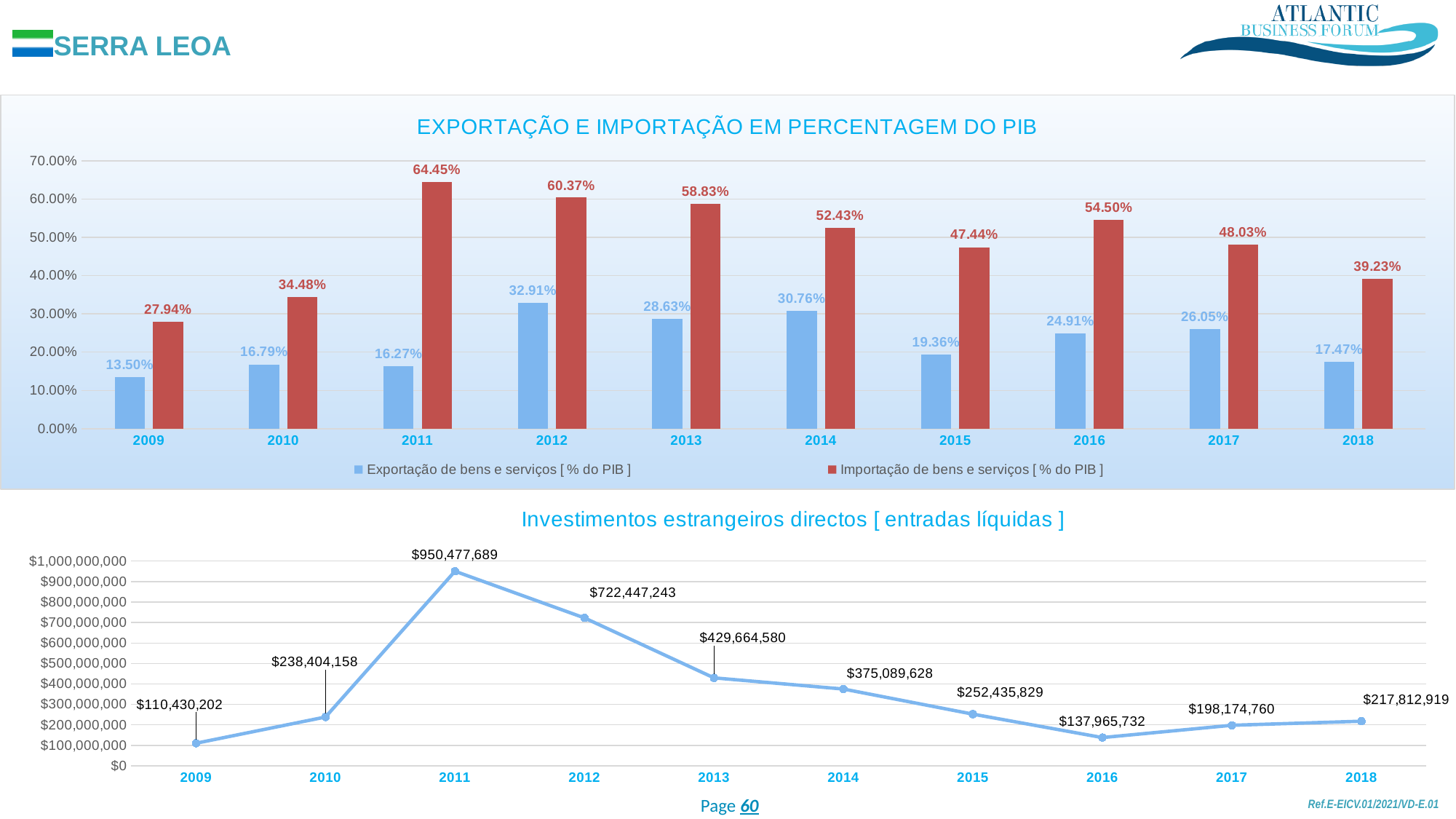
In the chart titled 'Investimentos estrangeiros directos [ entradas líquidas ]', how many years are plotted? 10 In the chart titled 'Investimentos estrangeiros directos [ entradas líquidas ]', what is the value for 2011? $950,477,689 In the chart titled 'Investimentos estrangeiros directos [ entradas líquidas ]', is the value for 2017 larger or smaller than the value for 2018? Smaller In the chart titled 'EXPORTAÇÃO E IMPORTAÇÃO EM PERCENTAGEM DO PIB', which year has the highest Exportação de bens e serviços value? 2012 In the chart titled 'EXPORTAÇÃO E IMPORTAÇÃO EM PERCENTAGEM DO PIB', how many series does the legend list? 2 In the chart titled 'EXPORTAÇÃO E IMPORTAÇÃO EM PERCENTAGEM DO PIB', what is the value of Importação de bens e serviços for 2011? 64.45% In the chart titled 'EXPORTAÇÃO E IMPORTAÇÃO EM PERCENTAGEM DO PIB', what is the value of Exportação de bens e serviços for 2014? 30.76% In the chart titled 'Investimentos estrangeiros directos [ entradas líquidas ]', do the values rise or fall from 2011 to 2016? Fall In the chart titled 'Investimentos estrangeiros directos [ entradas líquidas ]', which year has the lowest value? 2009 What kind of chart is the top chart titled 'EXPORTAÇÃO E IMPORTAÇÃO EM PERCENTAGEM DO PIB'? Bar chart In the chart titled 'EXPORTAÇÃO E IMPORTAÇÃO EM PERCENTAGEM DO PIB', which year has the lowest Importação de bens e serviços value? 2009 In the chart titled 'EXPORTAÇÃO E IMPORTAÇÃO EM PERCENTAGEM DO PIB', what is the difference between Importação and Exportação in 2018? 21.76%